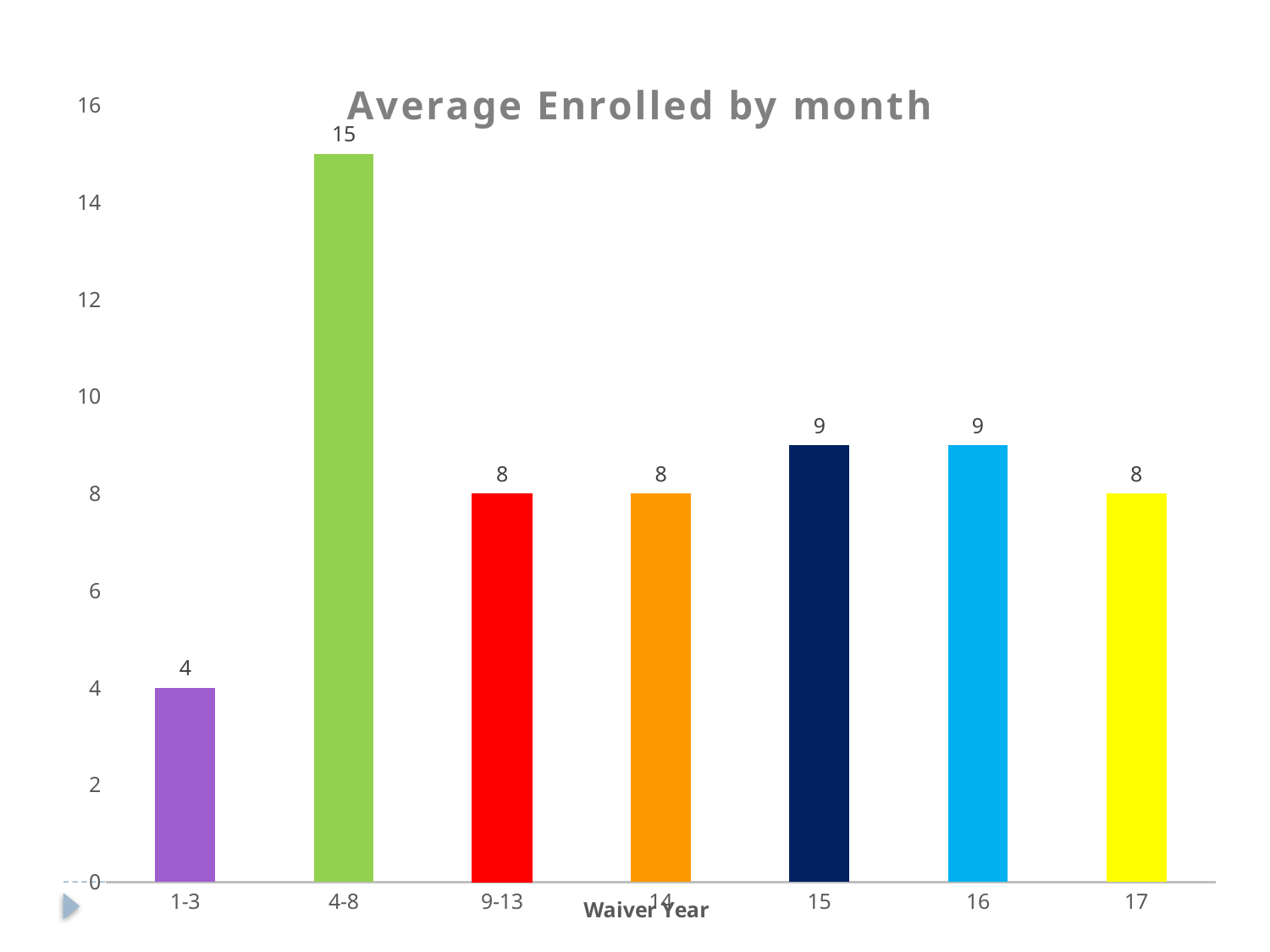
What is the average enrolled by month for waiver year 1-3? 4 Which is larger, the average enrolled by month for waiver year 16 or for waiver year 9-13? 16 What is the difference between the average enrolled by month for waiver year 4-8 and waiver year 1-3? 11 Which waiver year has the highest average enrolled by month? 4-8 What kind of chart is shown on the slide? Bar chart What is the average enrolled by month for waiver year 15? 9 Is the value for waiver year 4-8 greater or less than 14? greater Which waiver year has the lowest average enrolled by month? 1-3 What is the average enrolled by month for waiver year 17? 8 What is the average enrolled by month for waiver year 4-8? 15 How many waiver year categories are shown on the chart? 7 What is the title of the chart? Average Enrolled by month